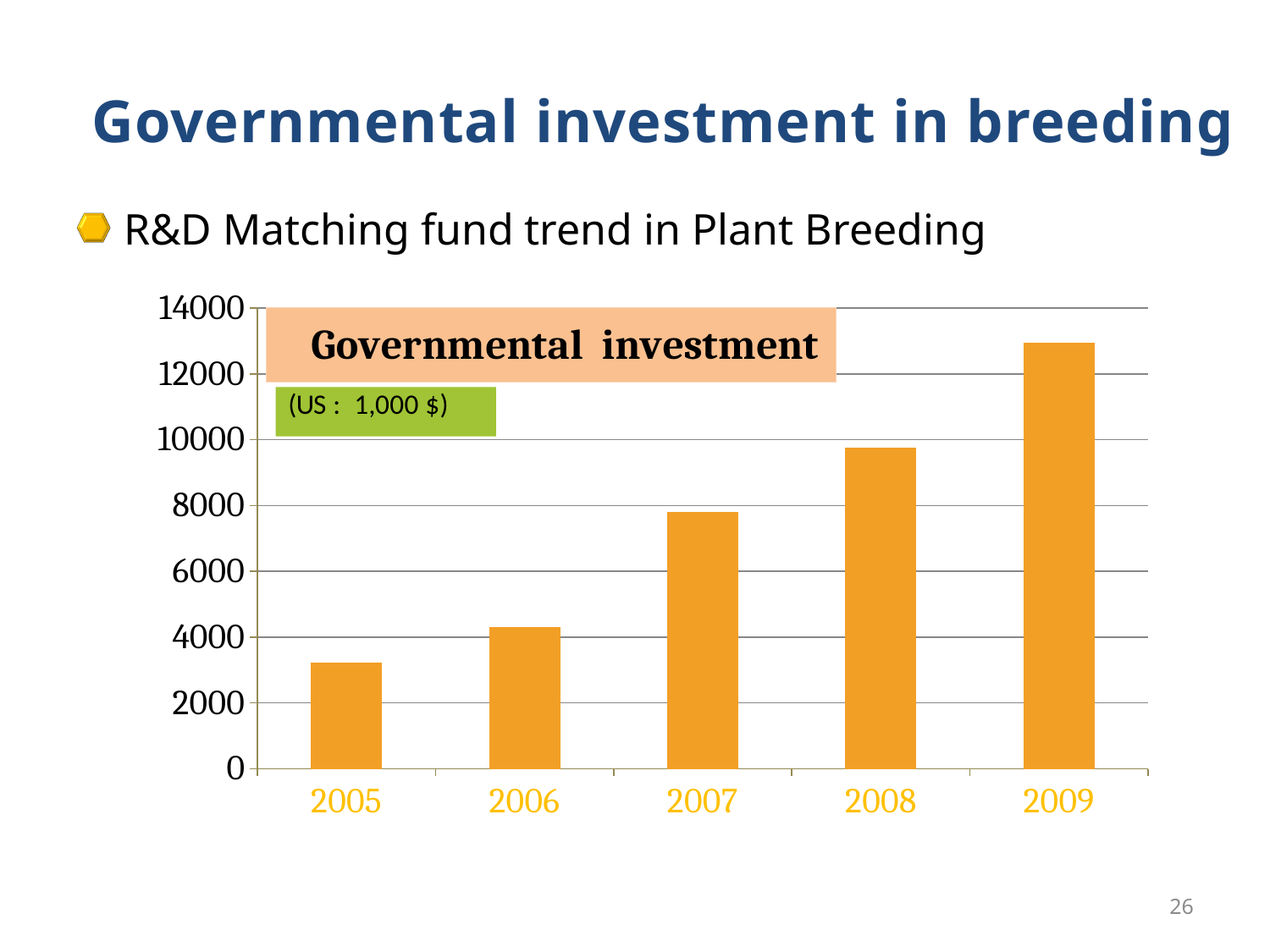
What unit is stated for the values in the chart? US : 1,000 $ Which is larger, the value for 2007 or the value for 2006? 2007 Is the value for 2008 greater or less than 8000? greater Is the value for 2009 greater or less than 12000? greater What kind of chart is shown on the slide? bar chart Do the values rise or fall from 2005 to 2009? rise Is the value for 2006 greater or less than 4000? greater Which year has the highest governmental investment in the chart? 2009 Which year has the lowest governmental investment in the chart? 2005 How many years are plotted on the x axis of the chart? 5